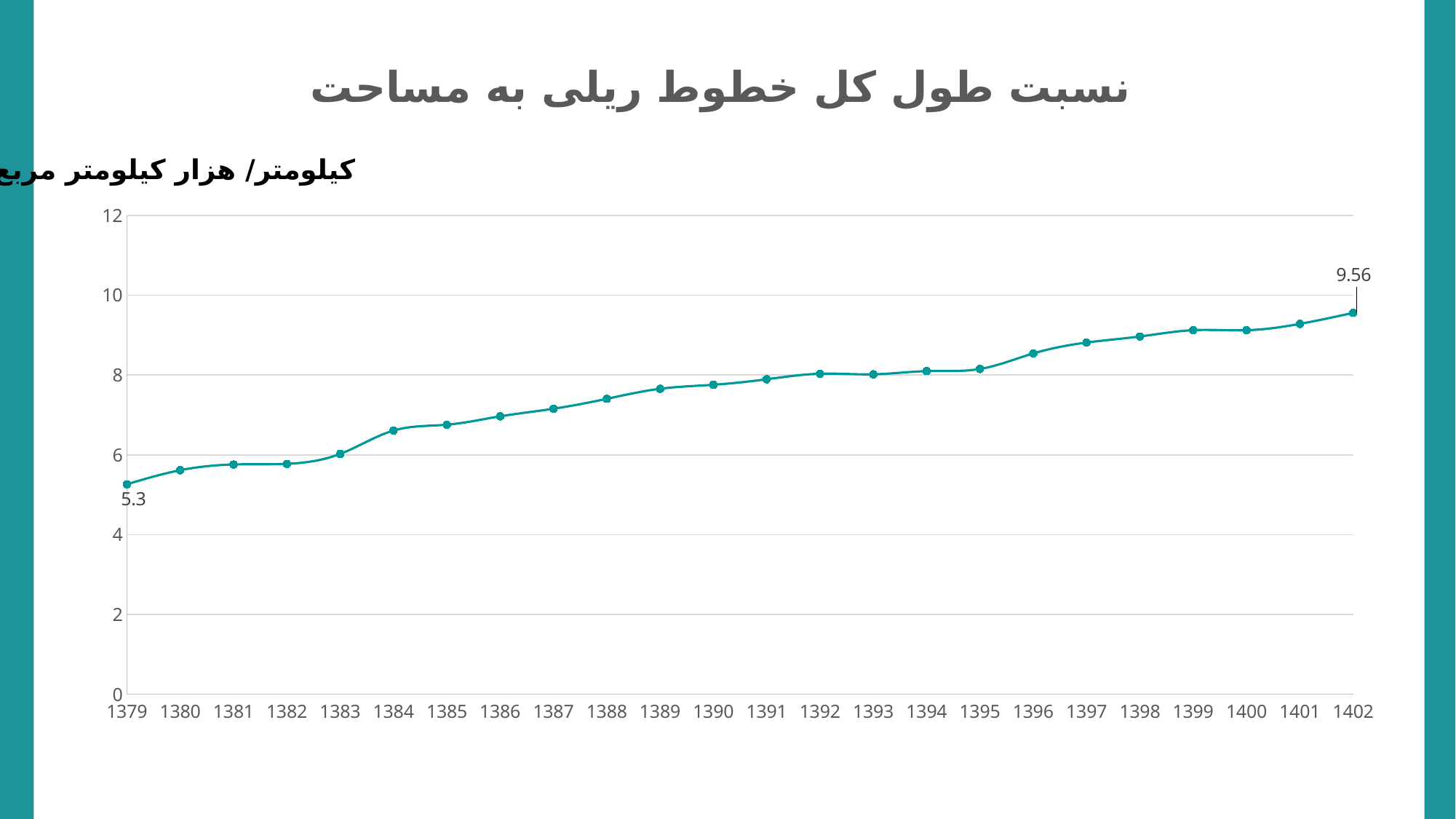
How many years are plotted on the x axis? 24 Which is larger, the value for 1384 or the value for 1380? 1384 Is the value for 1396 greater or less than 8? greater Which year has the highest value? 1402 What is the value for 1379? 5.3 What is the difference between the values for 1402 and 1379? 4.26 What kind of chart is shown on the slide? line chart What is the value for 1402? 9.56 Do the values rise or fall from 1379 to 1402? rise What unit label is shown above the chart? کیلومتر/ هزار کیلومتر مربع Is the value for 1390 greater or less than 8? less Which year has the lowest value? 1379